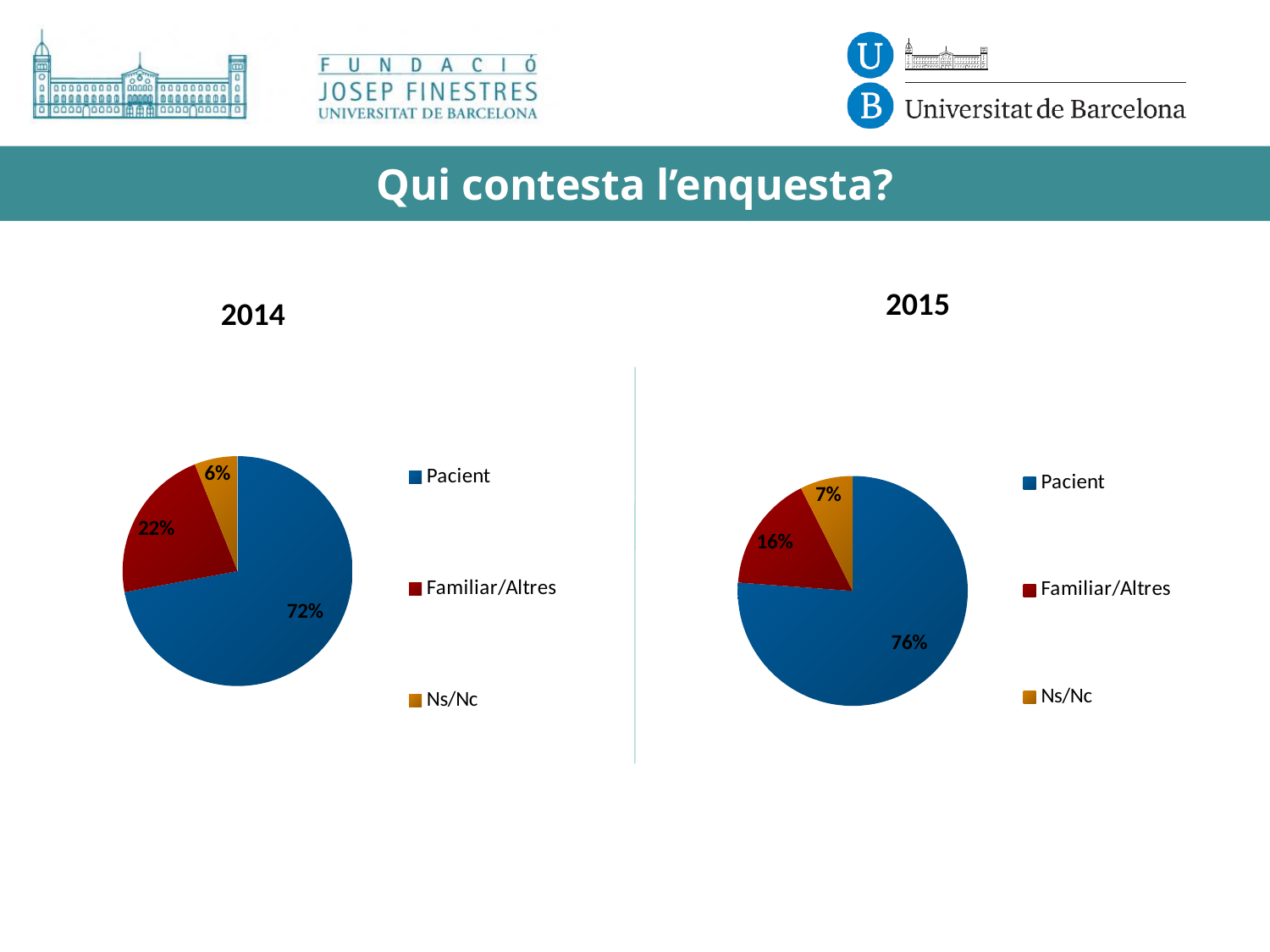
In the 2014 chart, what share of respondents were Pacient? 72% In the 2014 chart, which category has the smallest slice? Ns/Nc Is the Pacient share larger in the 2014 chart or the 2015 chart? 2015 How many categories does the 2014 chart show? 3 In the 2014 chart, what colour is the Ns/Nc slice? Orange What is the difference in percentage points between the Familiar/Altres share in 2014 and in 2015? 6 In the 2015 chart, what share of respondents were Ns/Nc? 7% In the 2015 chart, which category has the largest slice? Pacient In the 2014 chart, what share of respondents were Familiar/Altres? 22% What is the title of the slide containing the two charts? Qui contesta l'enquesta? What kind of chart is the 2015 chart? Pie chart In the 2015 chart, what share of respondents were Familiar/Altres? 16%